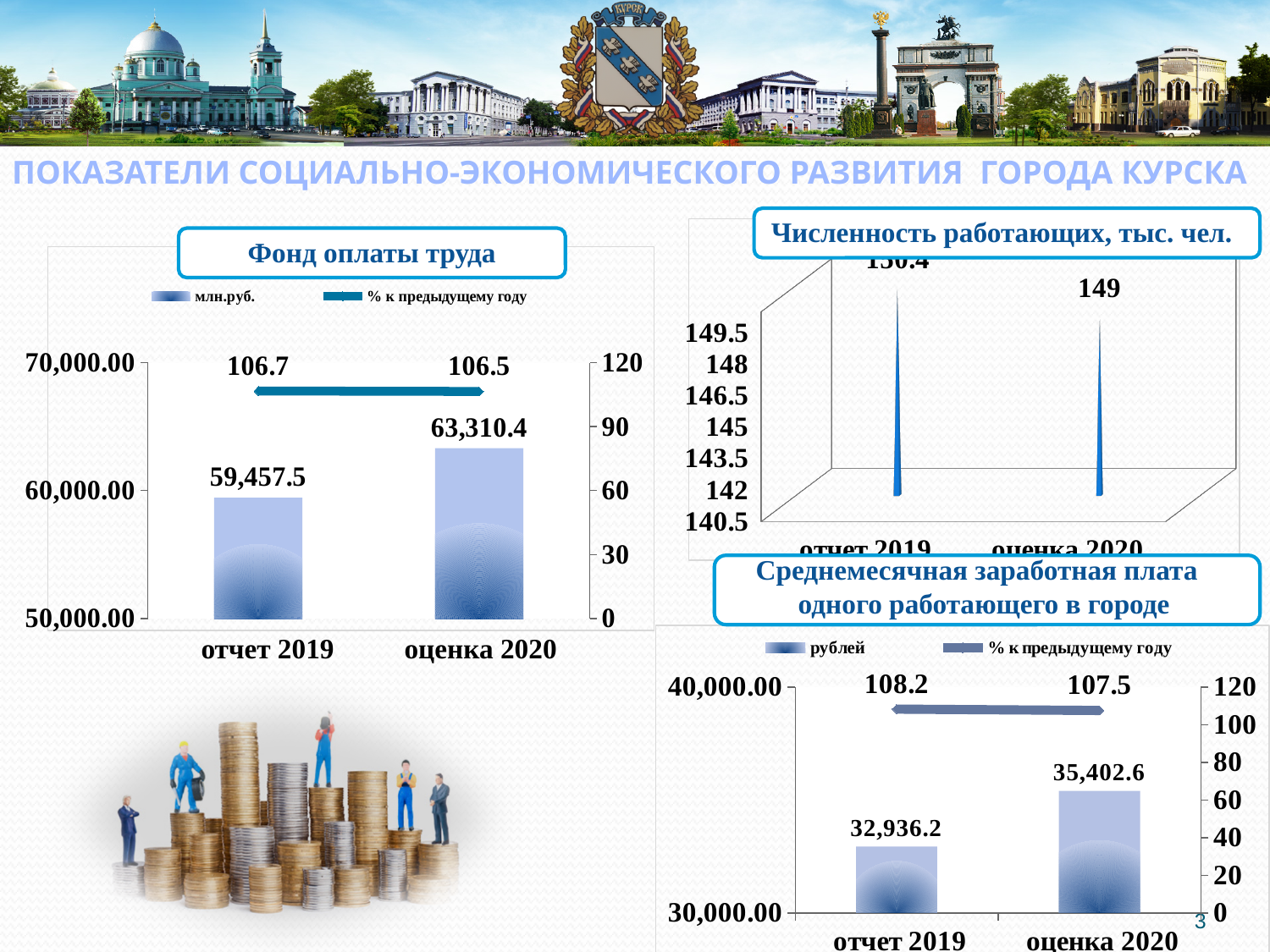
In the 'Фонд оплаты труда' chart, what is the value in млн.руб. for 'оценка 2020'? 63,310.4 In the 'Среднемесячная заработная плата одного работающего в городе' chart, what is the value in рублей for 'оценка 2020'? 35,402.6 In the 'Фонд оплаты труда' chart, what is the '% к предыдущему году' value for 'отчет 2019'? 106.7 In the 'Численность работающих, тыс. чел.' chart, do the values rise or fall from 'отчет 2019' to 'оценка 2020'? fall In the 'Среднемесячная заработная плата одного работающего в городе' chart, what is the '% к предыдущему году' value for 'оценка 2020'? 107.5 How many series does the legend of the 'Фонд оплаты труда' chart list? 2 In the 'Среднемесячная заработная плата одного работающего в городе' chart, what is the difference in рублей between 'оценка 2020' and 'отчет 2019'? 2,466.4 What kind of chart is the 'Среднемесячная заработная плата одного работающего в городе' chart? bar chart with a line In the 'Фонд оплаты труда' chart, what is the difference in млн.руб. between 'оценка 2020' and 'отчет 2019'? 3,852.9 In the 'Численность работающих, тыс. чел.' chart, which category has the higher value, 'отчет 2019' or 'оценка 2020'? отчет 2019 In the 'Численность работающих, тыс. чел.' chart, what is the value for 'оценка 2020'? 149 In the 'Фонд оплаты труда' chart, what is the value in млн.руб. for 'отчет 2019'? 59,457.5